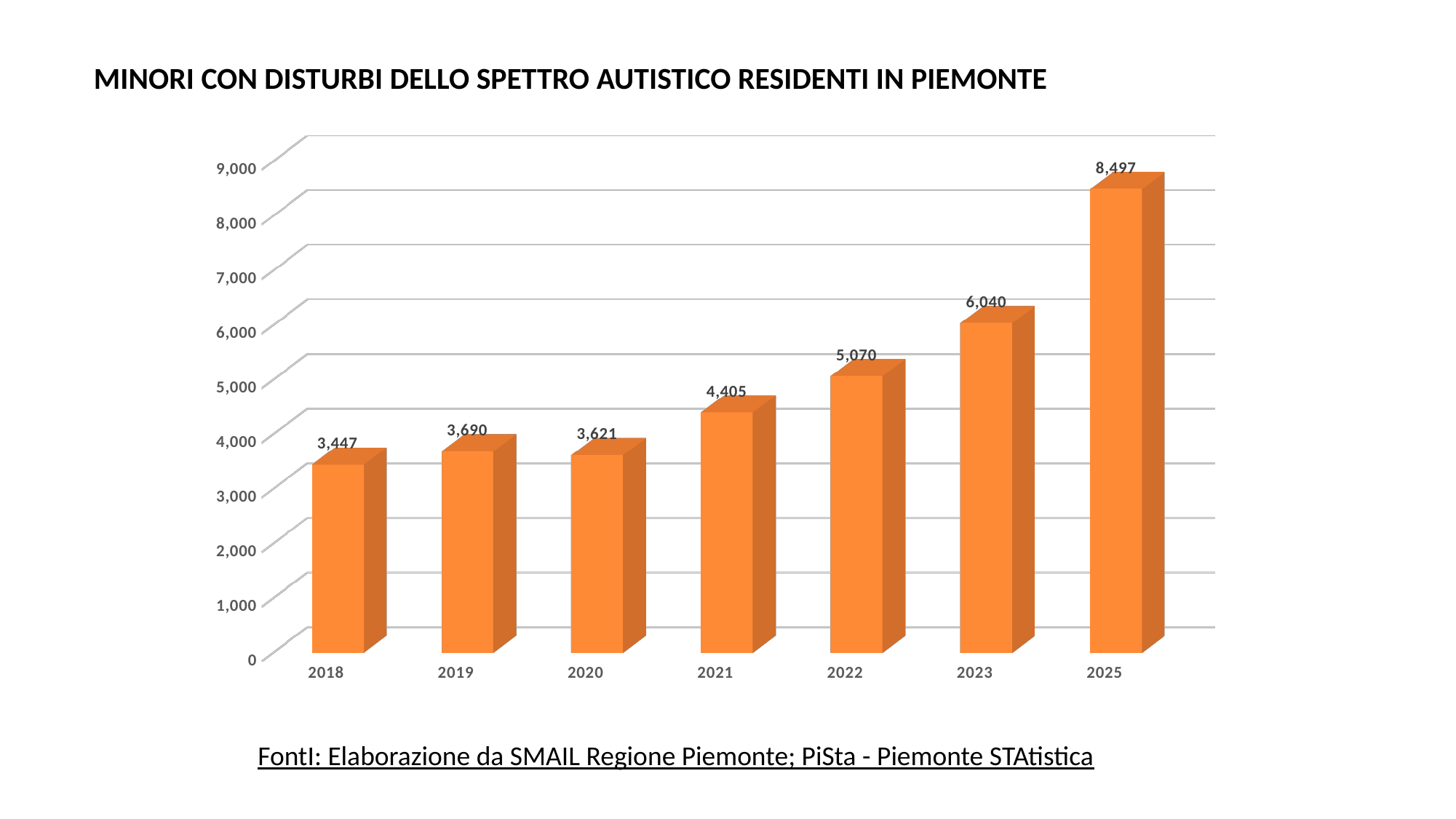
Which year has the highest value? 2025 Which year has the lowest value? 2018 What kind of chart is shown on the slide? Bar chart What is the difference between the values for 2025 and 2023? 2,457 Which is larger, the value for 2019 or the value for 2020? 2019 How many years are shown on the x axis? 7 What is the difference between the values for 2019 and 2020? 69 Is the value for 2022 greater or less than 5,000? greater What is the value for 2023? 6,040 What is the title of the chart? MINORI CON DISTURBI DELLO SPETTRO AUTISTICO RESIDENTI IN PIEMONTE What is the value for 2021? 4,405 What is the value for 2018? 3,447